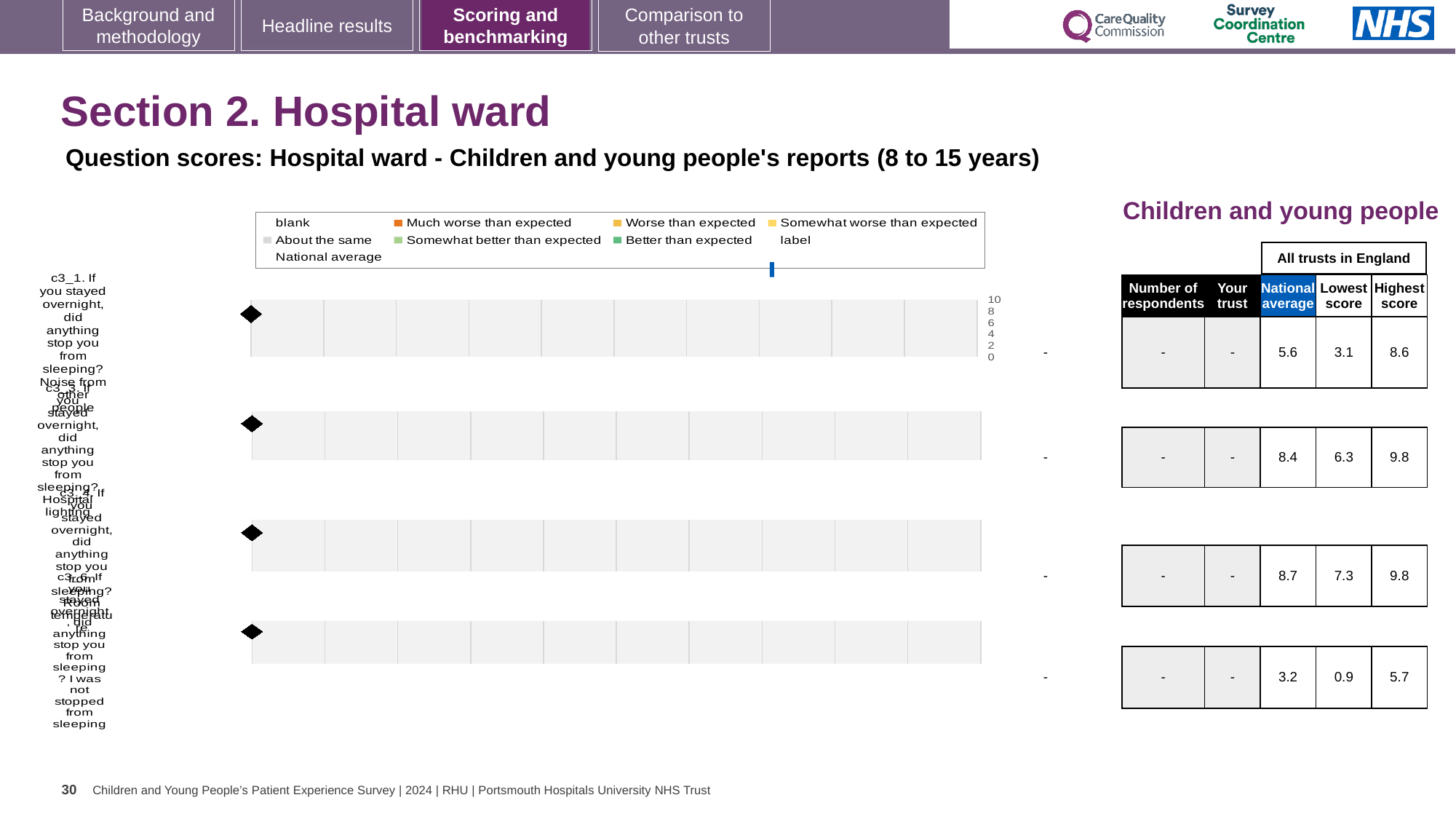
In the score table, what is the highest score for question c3_4 (third row)? 9.8 What is the maximum value shown on the chart's value axis? 10 What kind of chart is used to display the question scores on this slide? bar chart In the score table, what is the national average for question c3_1 (first row)? 5.6 What is the difference between the highest score and the lowest score for question c3_6 (fourth row)? 4.8 In the score table, what is the lowest score for question c3_6 (fourth row)? 0.9 What heading appears above the score table on the right of the slide? Children and young people Which question row has the lowest national average in the score table? c3_6 (fourth row), 3.2 What value is shown for 'Your trust' for question c3_1 (first row)? - Which question row has the highest national average in the score table? c3_4 (third row), 8.7 How many question charts are shown on the slide? 4 How many entries does the chart legend list? 9